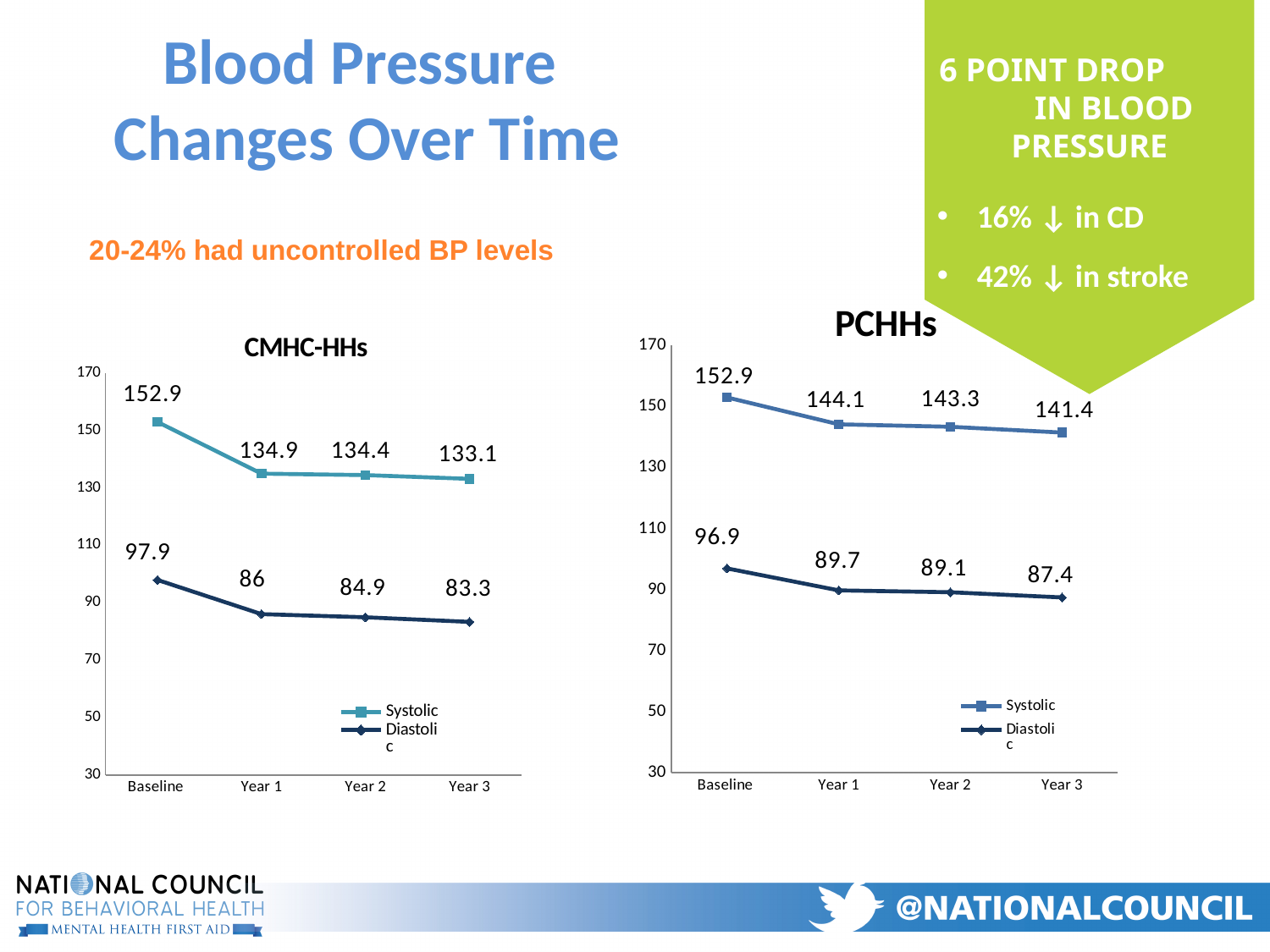
In the PCHHs chart, what is the Diastolic value at Baseline? 96.9 What kind of chart is the PCHHs chart? Line chart In the CMHC-HHs chart, what is the Diastolic value at Year 3? 83.3 In the CMHC-HHs chart, what is the Systolic value at Baseline? 152.9 In the CMHC-HHs chart, at which time point is the Systolic value lowest? Year 3 In the CMHC-HHs chart, what is the difference between the Systolic values at Baseline and Year 1? 18 In the PCHHs chart, at which time point is the Diastolic value highest? Baseline How many series does the legend of the CMHC-HHs chart list? 2 How many time points are shown on the x axis of the PCHHs chart? 4 In the PCHHs chart, what is the Systolic value at Year 1? 144.1 In the PCHHs chart, what is the difference between the Diastolic values at Baseline and Year 3? 9.5 Which is larger: the Year 2 Systolic value in the CMHC-HHs chart or the Year 2 Systolic value in the PCHHs chart? PCHHs